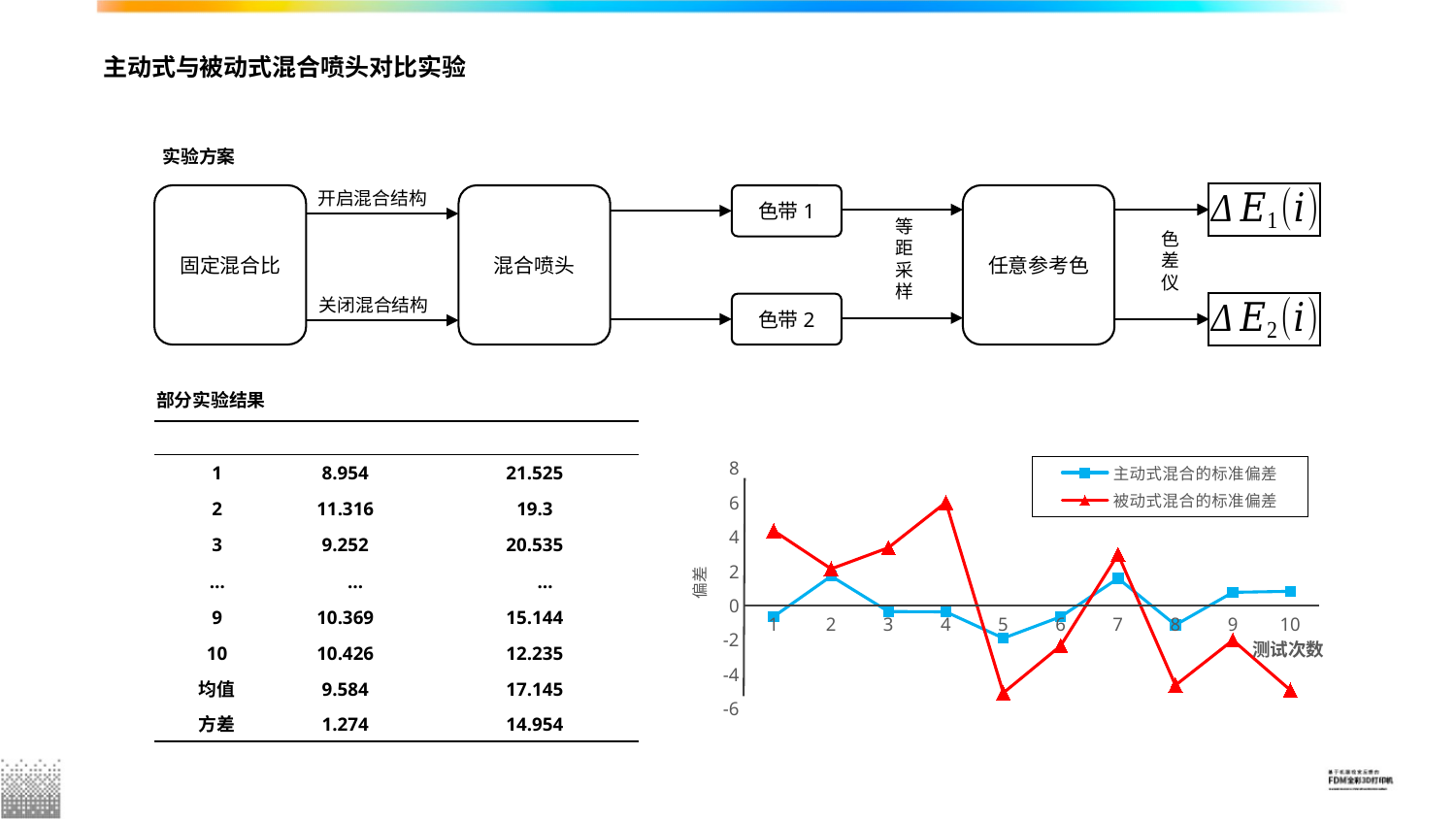
Is the value of 主动式混合的标准偏差 at test 5 greater or less than 0? less What is the title of the x axis of the chart? 测试次数 At test 5, which series has the larger value, 主动式混合的标准偏差 or 被动式混合的标准偏差? 主动式混合的标准偏差 Which series is drawn with red triangle markers in the chart? 被动式混合的标准偏差 How many test points (测试次数) are plotted along the x axis of the chart? 10 What kind of chart is shown on the slide? line chart Is the value of 被动式混合的标准偏差 at test 4 greater or less than 4? greater At test 4, which series has the larger value, 主动式混合的标准偏差 or 被动式混合的标准偏差? 被动式混合的标准偏差 At which test number does the 被动式混合的标准偏差 series reach its highest value? 4 At which test number does the 主动式混合的标准偏差 series reach its lowest value? 5 Is the value of 被动式混合的标准偏差 at test 5 less or greater than -4? less How many series does the chart legend list? 2